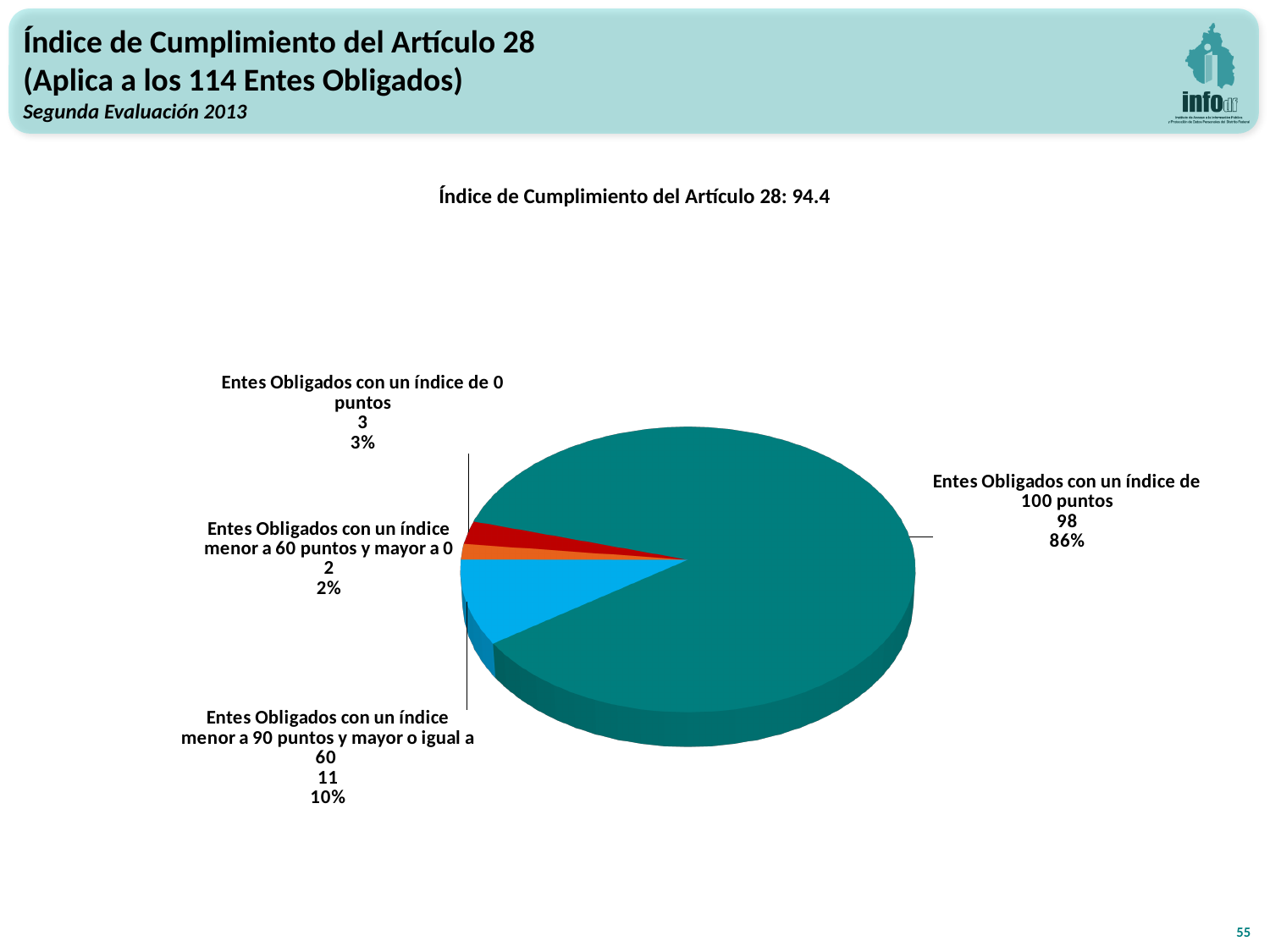
What is the difference between the number of Entes Obligados with an index of 100 points and those with an index lower than 90 and greater than or equal to 60? 87 How many Entes Obligados have an index of 100 points? 98 How many Entes Obligados have an index of 0 points? 3 How many slices does the pie chart have? 4 What share of the pie corresponds to Entes Obligados with an index of 100 points? 86% Which category has the largest slice of the pie? Entes Obligados con un índice de 100 puntos How many Entes Obligados have an index lower than 90 points and greater than or equal to 60? 11 What percentage is shown for Entes Obligados with an index lower than 60 points and greater than 0? 2% Which is larger: the number of Entes Obligados with an index of 0 points or those with an index lower than 60 points and greater than 0? Entes Obligados con un índice de 0 puntos Which category has the smallest slice of the pie? Entes Obligados con un índice menor a 60 puntos y mayor a 0 What value of the Índice de Cumplimiento del Artículo 28 is stated in the chart title? 94.4 What kind of chart is shown on the slide? Pie chart